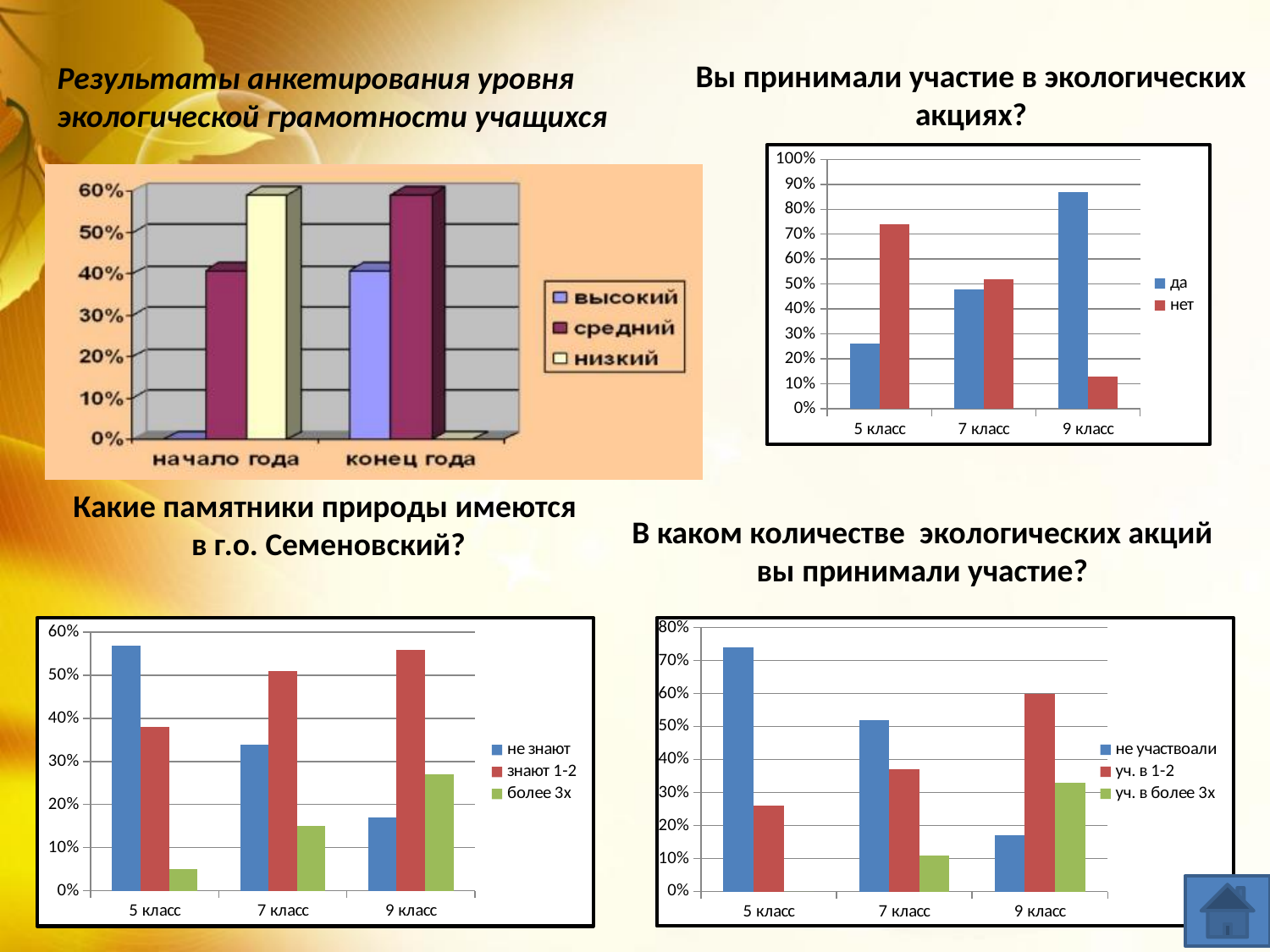
In the chart titled "В каком количестве экологических акций вы принимали участие?", is the value for "не участвоали" in 5 класс greater or less than 70%? greater In the chart titled "Вы принимали участие в экологических акциях?", is the value for "нет" in 5 класс greater or less than 70%? greater In the chart titled "Вы принимали участие в экологических акциях?", which class has the highest value for "да"? 9 класс In the chart titled "Вы принимали участие в экологических акциях?", does the value for "да" rise or fall from 5 класс to 9 класс? rise In the top-left chart titled "Результаты анкетирования уровня экологической грамотности учащихся", which series is larger for "начало года": "средний" or "низкий"? низкий In the chart titled "В каком количестве экологических акций вы принимали участие?", which series is larger for 9 класс: "не участвоали" or "уч. в 1-2"? уч. в 1-2 In the chart titled "Какие памятники природы имеются в г.о. Семеновский?", which class has the lowest value for "не знают"? 9 класс In the chart titled "Вы принимали участие в экологических акциях?", how many series does the legend list? 2 In the chart titled "Какие памятники природы имеются в г.о. Семеновский?", how many categories are shown on the x axis? 3 In the chart titled "В каком количестве экологических акций вы принимали участие?", what kind of chart is it? bar chart In the chart titled "Какие памятники природы имеются в г.о. Семеновский?", is the value for "более 3х" in 5 класс greater or less than 10%? less In the top-left chart titled "Результаты анкетирования уровня экологической грамотности учащихся", what colour represents the "средний" series? purple